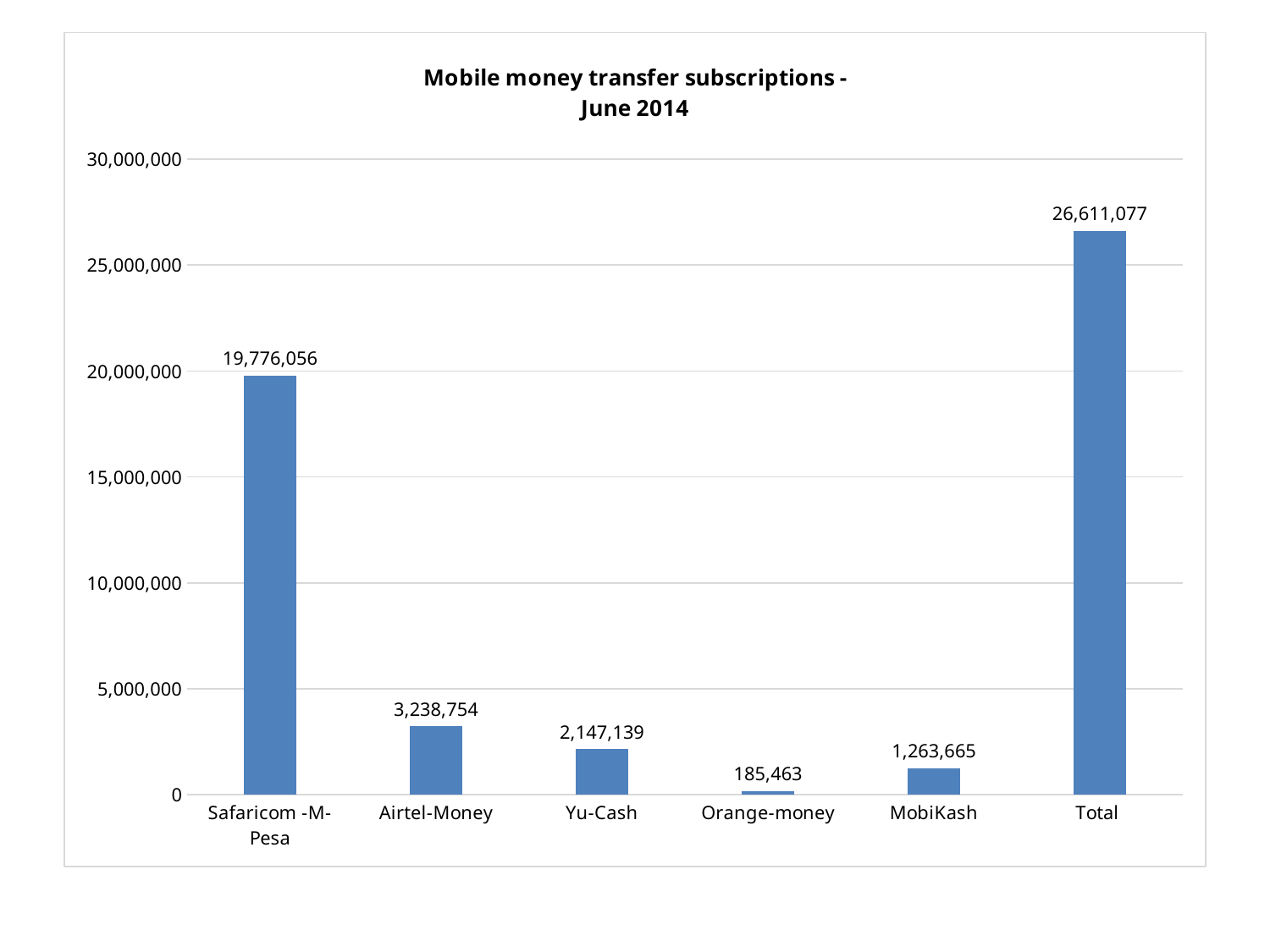
What is the title of the chart? Mobile money transfer subscriptions - June 2014 Which category has the lowest value? Orange-money What is the difference between Airtel-Money and Yu-Cash? 1,091,615 Excluding the Total bar, which provider has the highest number of subscriptions? Safaricom -M-Pesa How many bars are shown on the chart? 6 What kind of chart is this? bar chart What is the value shown for the Total bar? 26,611,077 Which is larger, MobiKash or Orange-money? MobiKash What is the value for Orange-money? 185,463 What is the value for Safaricom -M-Pesa? 19,776,056 What is the difference between the Total and Safaricom -M-Pesa? 6,835,021 Is the value for Airtel-Money greater or less than 5,000,000? less